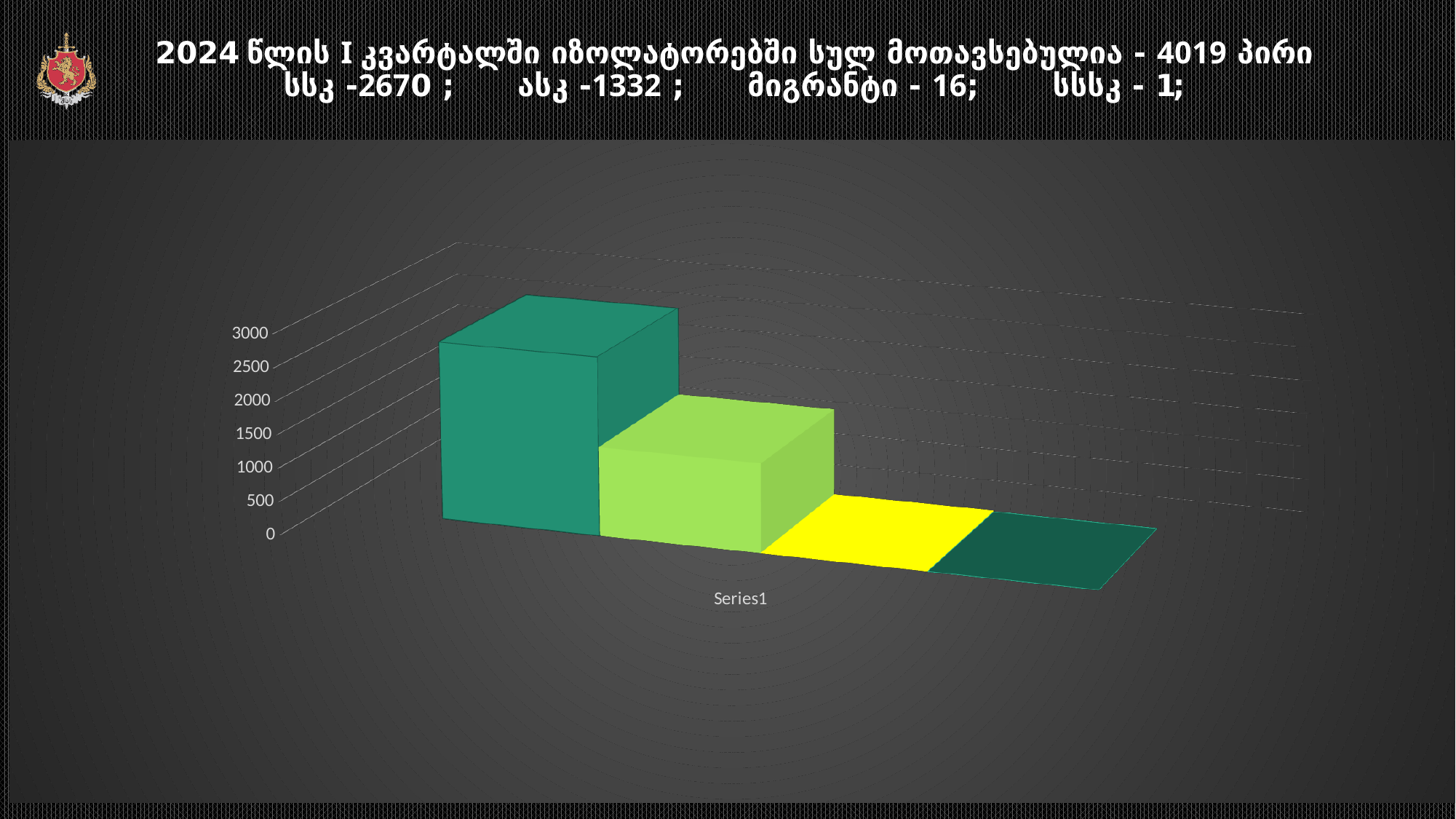
Is the value of the second bar from the left greater or less than 1000? greater What label is shown beneath the bars on the horizontal axis? Series1 How many bars are plotted in the chart? 4 What kind of chart is shown on the slide? bar chart Is the value of the first (leftmost) bar greater or less than 3000? less Is the value of the second bar from the left greater or less than 1500? less Which is larger, the first bar or the second bar from the left? the first bar Do the bar values rise or fall from left to right across the chart? fall What is the highest value labelled on the vertical axis? 3000 Which bar is the tallest in the chart? the first (leftmost) bar